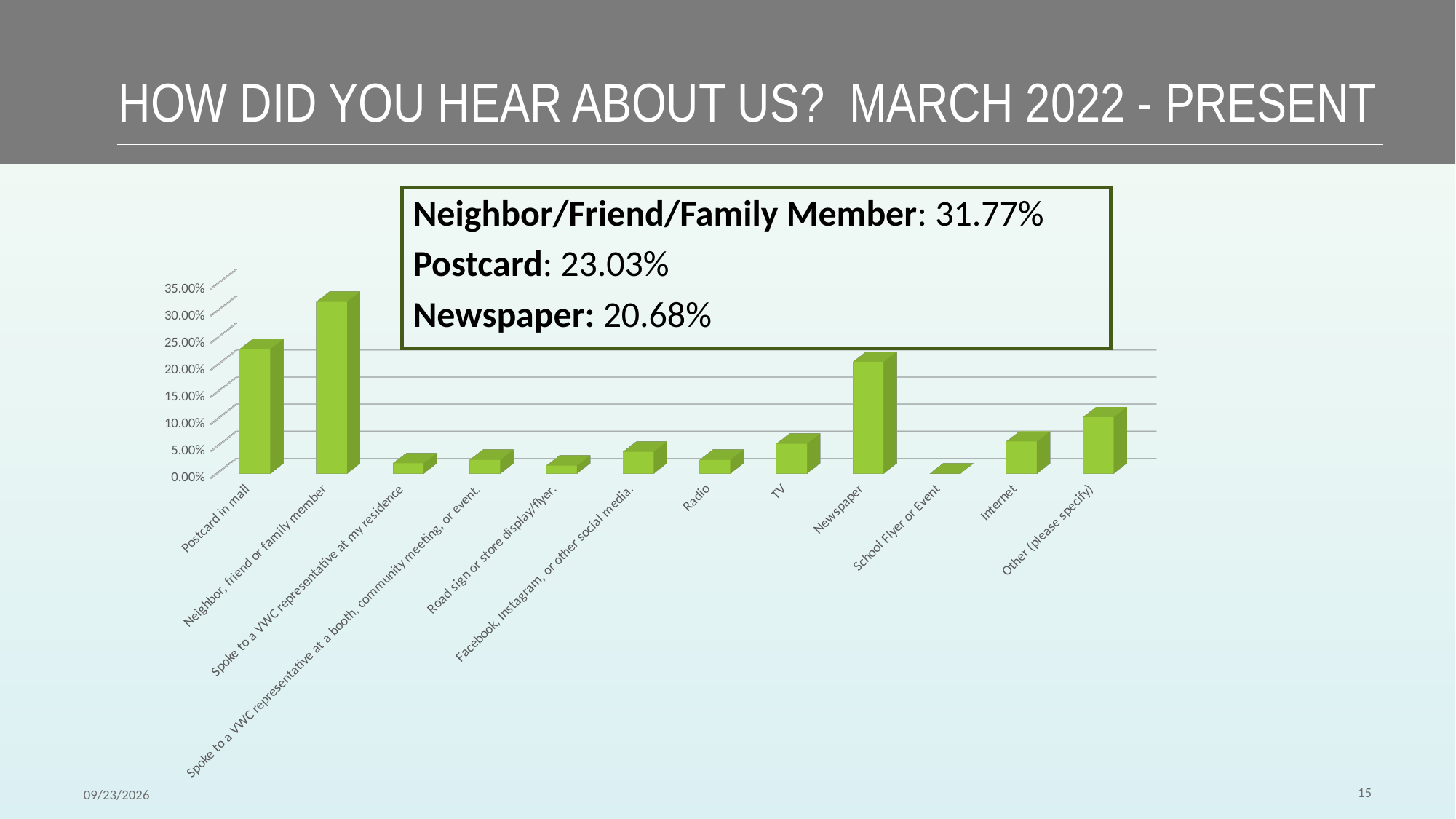
What is the title of the slide containing the chart? HOW DID YOU HEAR ABOUT US? MARCH 2022 - PRESENT Which category has the highest value? Neighbor, friend or family member What kind of chart is shown on the slide? bar chart Which is larger, the value for TV or the value for Radio? TV Which category has the lowest value? School Flyer or Event What is the value for Newspaper? 20.68% What is the value for Postcard? 23.03% How many categories are plotted on the chart? 12 Is the value for Radio greater or less than 5.00%? less What is the value for Neighbor/Friend/Family Member? 31.77% What is the difference between the Neighbor/Friend/Family Member value and the Postcard value? 8.74% Which is larger, the value for Postcard in mail or the value for Newspaper? Postcard in mail